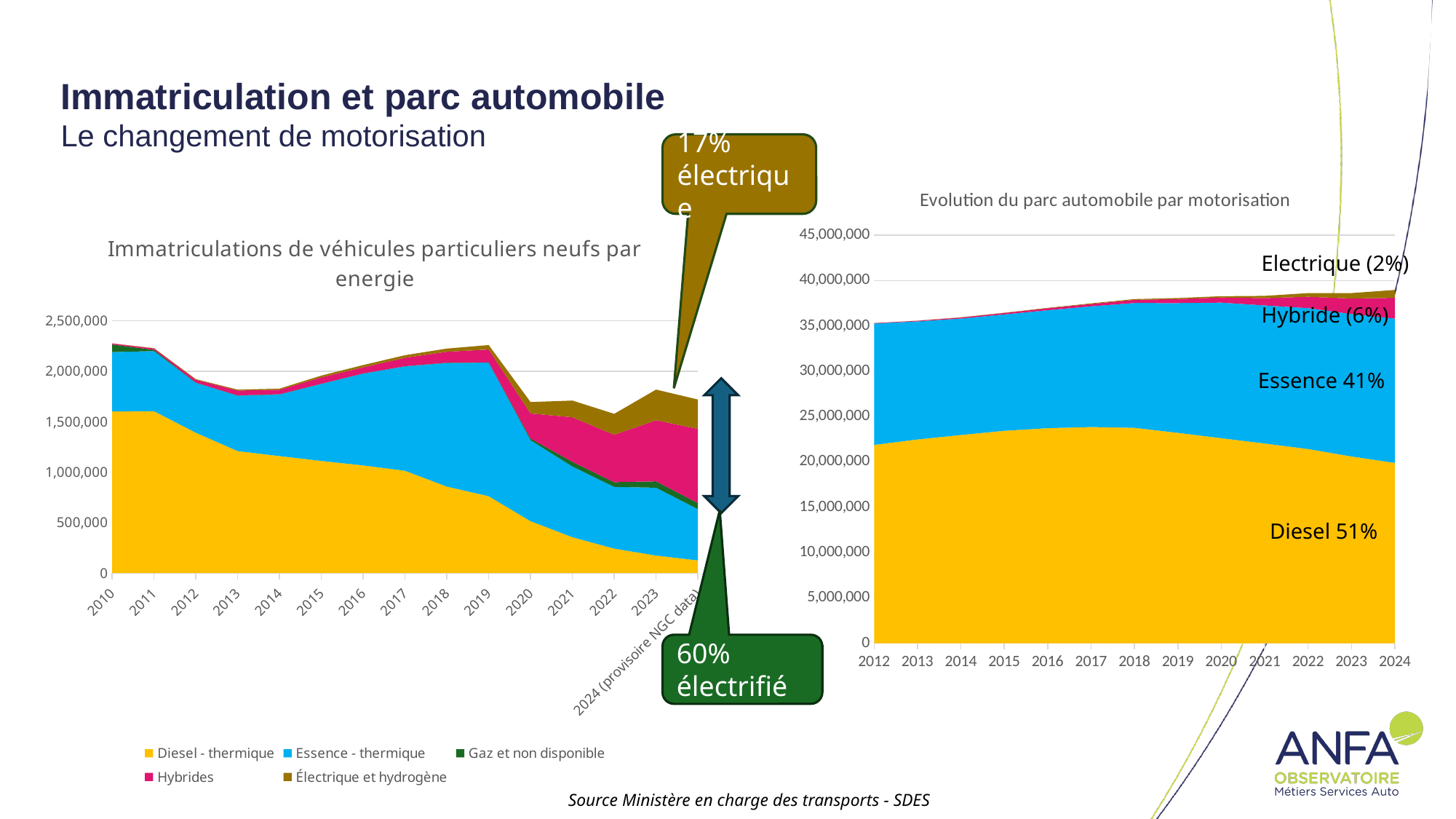
In the right chart 'Evolution du parc automobile par motorisation', which motorisation has the smallest labelled share? Electrique (2%) In the right chart 'Evolution du parc automobile par motorisation', how many years are shown on the x axis? 13 In the left chart 'Immatriculations de véhicules particuliers neufs par energie', does the Diesel - thermique area rise or fall from 2010 to 2024? Fall In the left chart 'Immatriculations de véhicules particuliers neufs par energie', is the total of all series in 2019 greater or less than 2,000,000? greater In the right chart 'Evolution du parc automobile par motorisation', what share is labelled for Essence? 41% In the right chart 'Evolution du parc automobile par motorisation', what share is labelled for Diesel? 51% What kind of chart is the left chart, 'Immatriculations de véhicules particuliers neufs par energie'? Stacked area chart In the right chart 'Evolution du parc automobile par motorisation', which motorisation has the largest labelled share? Diesel (51%) In the left chart 'Immatriculations de véhicules particuliers neufs par energie', how many series does the legend list? 5 In the right chart 'Evolution du parc automobile par motorisation', what is the difference in percentage points between the Diesel share and the Essence share? 10 percentage points In the left chart 'Immatriculations de véhicules particuliers neufs par energie', how many years are shown on the x axis? 15 In the right chart 'Evolution du parc automobile par motorisation', is the total parc in 2024 greater or less than 35,000,000? greater